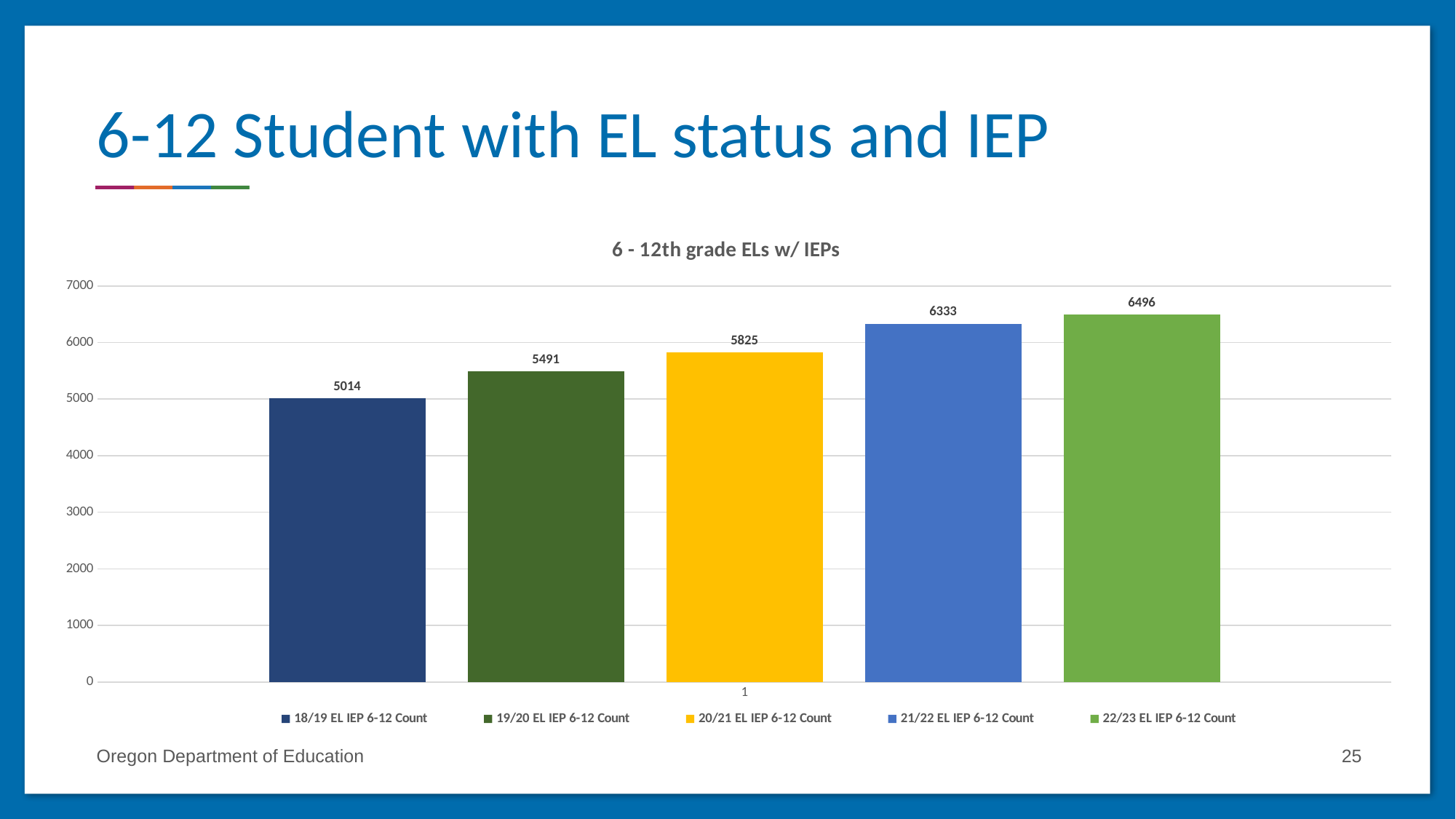
What is the value for 18/19 EL IEP 6-12 Count? 5014 Which series has the lowest value? 18/19 EL IEP 6-12 Count What is the difference between the 22/23 and 18/19 EL IEP 6-12 Count values? 1482 What is the value for 20/21 EL IEP 6-12 Count? 5825 Which series has the highest value? 22/23 EL IEP 6-12 Count Do the values rise or fall from the 18/19 series to the 22/23 series? rise How many series does the legend list? 5 What kind of chart is shown on the slide? bar chart What is the value for 22/23 EL IEP 6-12 Count? 6496 Is the value for 19/20 EL IEP 6-12 Count greater or less than 6000? less What is the difference between the 21/22 and 20/21 EL IEP 6-12 Count values? 508 Which is larger, the 19/20 EL IEP 6-12 Count or the 21/22 EL IEP 6-12 Count? 21/22 EL IEP 6-12 Count